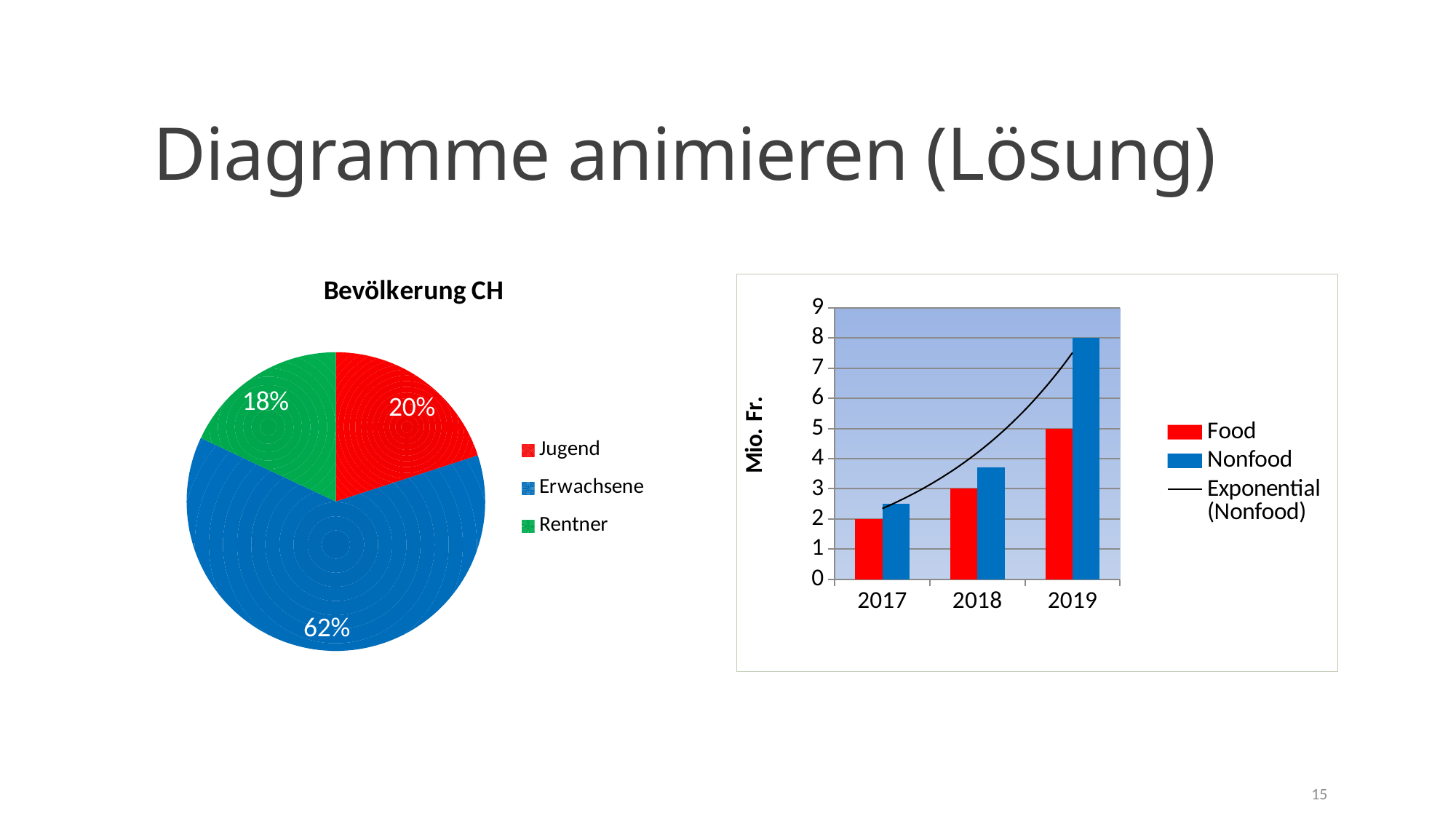
In the pie chart titled Bevölkerung CH, how many categories are shown? 3 In the pie chart titled Bevölkerung CH, which category has the largest share? Erwachsene In the pie chart titled Bevölkerung CH, how many percentage points larger is Jugend than Rentner? 2 What kind of chart is the chart on the right of the slide? bar chart In the bar chart on the right, how many entries does the legend list? 3 In the pie chart titled Bevölkerung CH, what share does Rentner have? 18% In the bar chart on the right, do the Nonfood values rise or fall from 2017 to 2019? rise In the bar chart on the right, is the value for Nonfood in 2018 greater or less than 3? greater In the pie chart titled Bevölkerung CH, which category has the smallest share? Rentner In the bar chart on the right, what is the value for Nonfood in 2019? 8 In the bar chart on the right, what is the value for Food in 2019? 5 In the pie chart titled Bevölkerung CH, what share does Erwachsene have? 62%